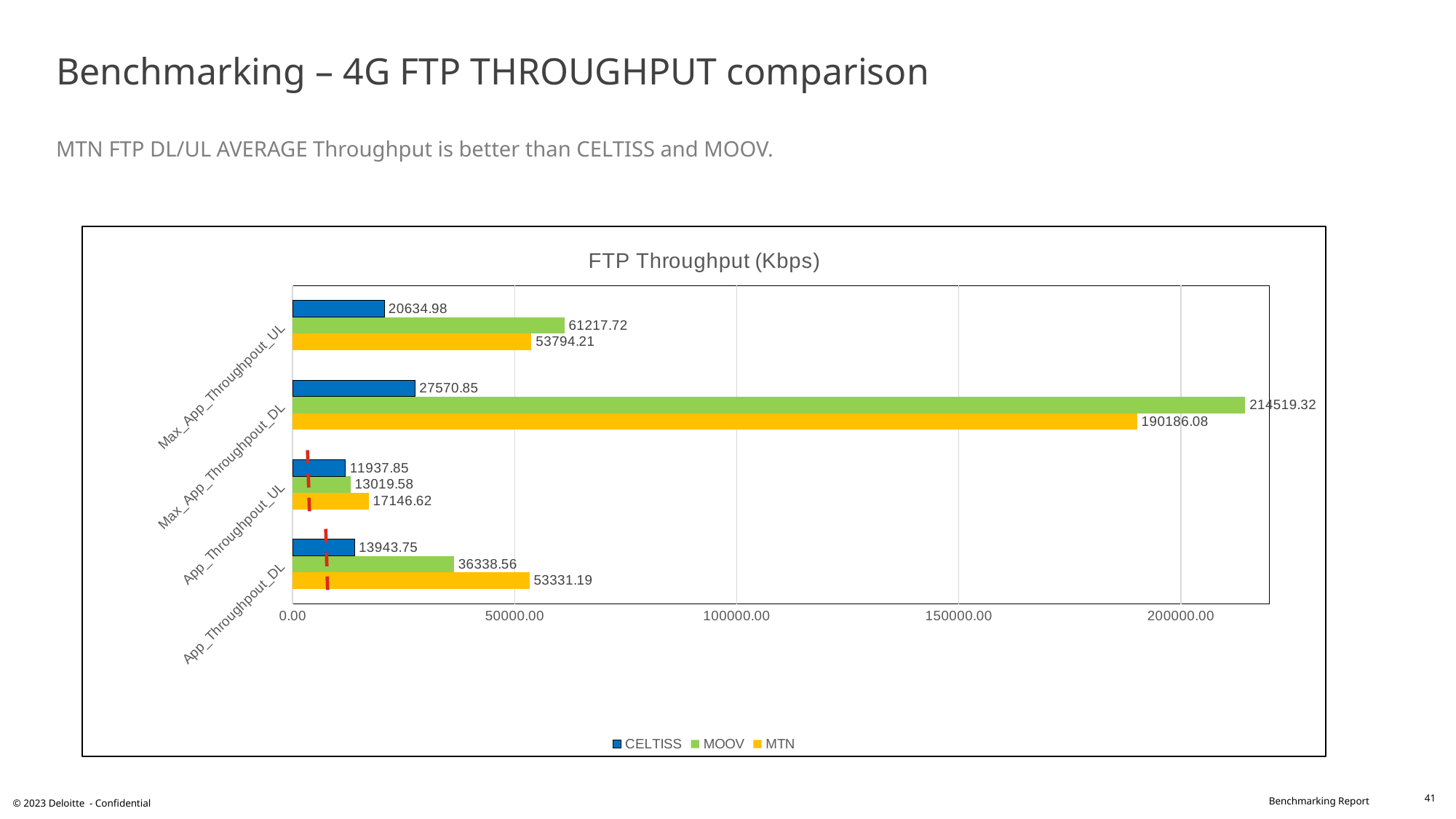
Which is larger for Max_App_Throughpout_UL, the MOOV value or the MTN value? MOOV What is the MTN value for App_Throughpout_DL? 53331.19 What is the MOOV value for Max_App_Throughpout_DL? 214519.32 What is the CELTISS value for Max_App_Throughpout_UL? 20634.98 Which series has the highest value for Max_App_Throughpout_DL? MOOV What kind of chart is shown on the slide? Bar chart Which series has the lowest value for App_Throughpout_DL? CELTISS How many series does the legend list? 3 What is the MTN value for App_Throughpout_UL? 17146.62 How many categories are shown on the chart? 4 What is the difference between the MTN and MOOV values for App_Throughpout_DL? 16992.63 What is the difference between the MOOV and MTN values for Max_App_Throughpout_DL? 24333.24